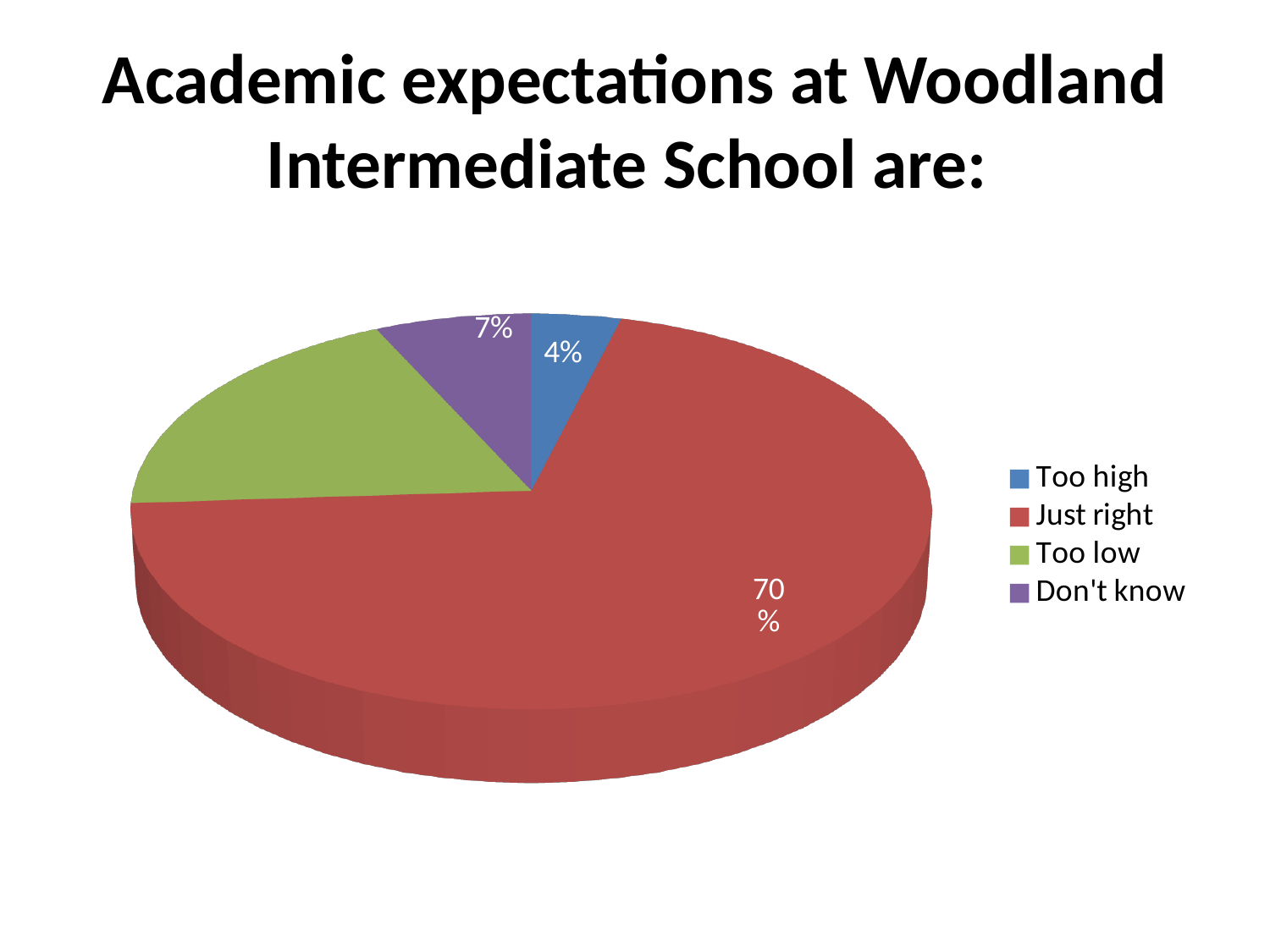
What is the difference in percentage points between "Don't know" and "Too high"? 3 Which slice is larger, "Just right" or "Too low"? Just right What kind of chart is shown on the slide? Pie chart What percentage of respondents said academic expectations are "Too high"? 4% How many response categories are shown in the pie chart? 4 What is the difference in percentage points between "Just right" and "Too high"? 66 What colour is the "Just right" slice? Red What percentage of respondents said academic expectations are "Just right"? 70% Which slice is larger, "Too low" or "Don't know"? Too low Which response has the largest share of the pie? Just right What percentage of respondents answered "Don't know"? 7% Which response has the smallest share of the pie? Too high